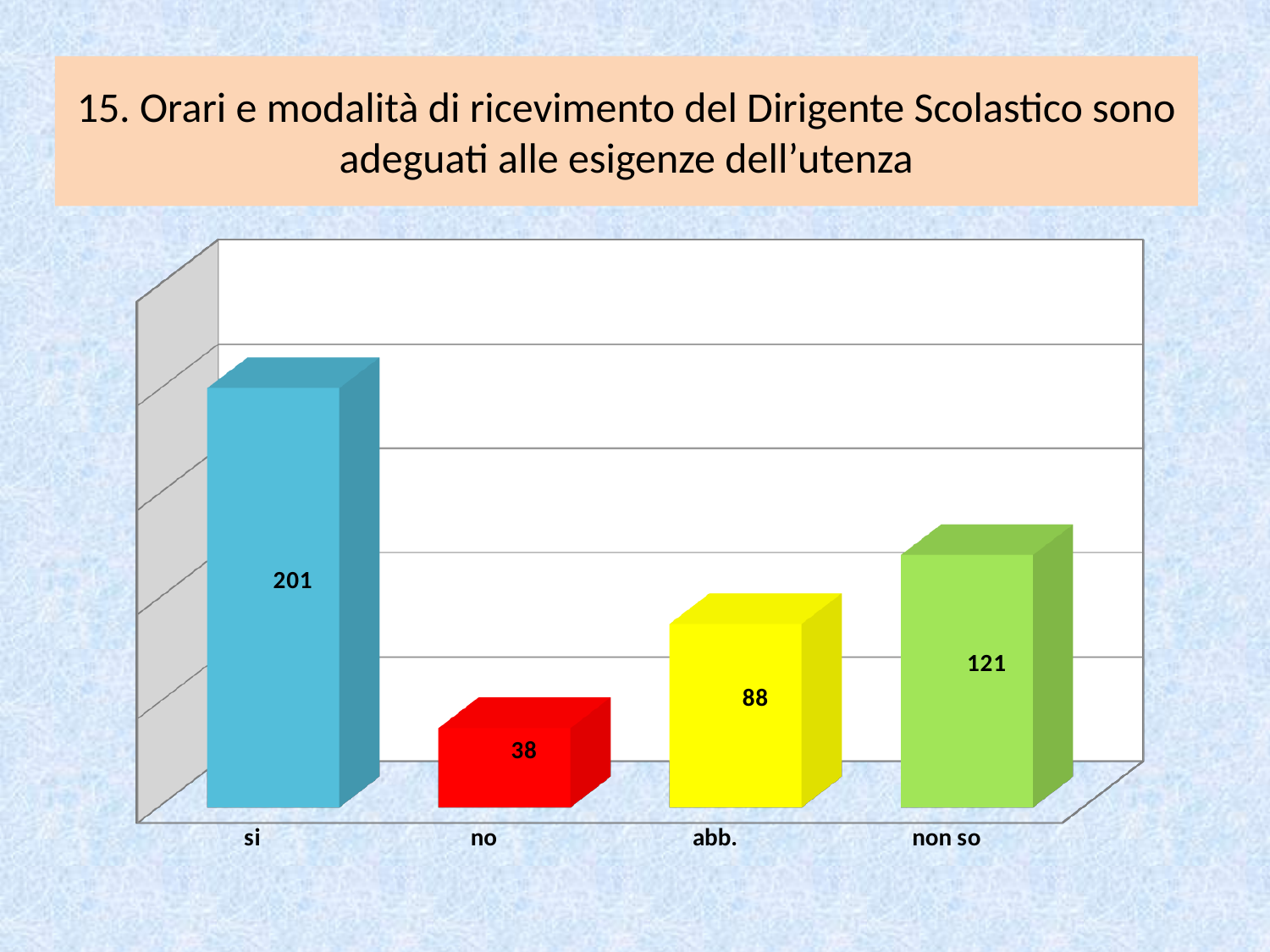
What kind of chart is shown on the slide? bar chart What is the value for "abb."? 88 Which is larger, the value for "abb." or the value for "non so"? non so Which category has the highest value? si What is the value for "non so"? 121 How many categories are shown in the chart? 4 What colour is the bar for "no"? red Which category has the lowest value? no What is the value for "no"? 38 What is the value for "si"? 201 What is the difference between the values for "si" and "non so"? 80 What is the difference between the values for "abb." and "no"? 50